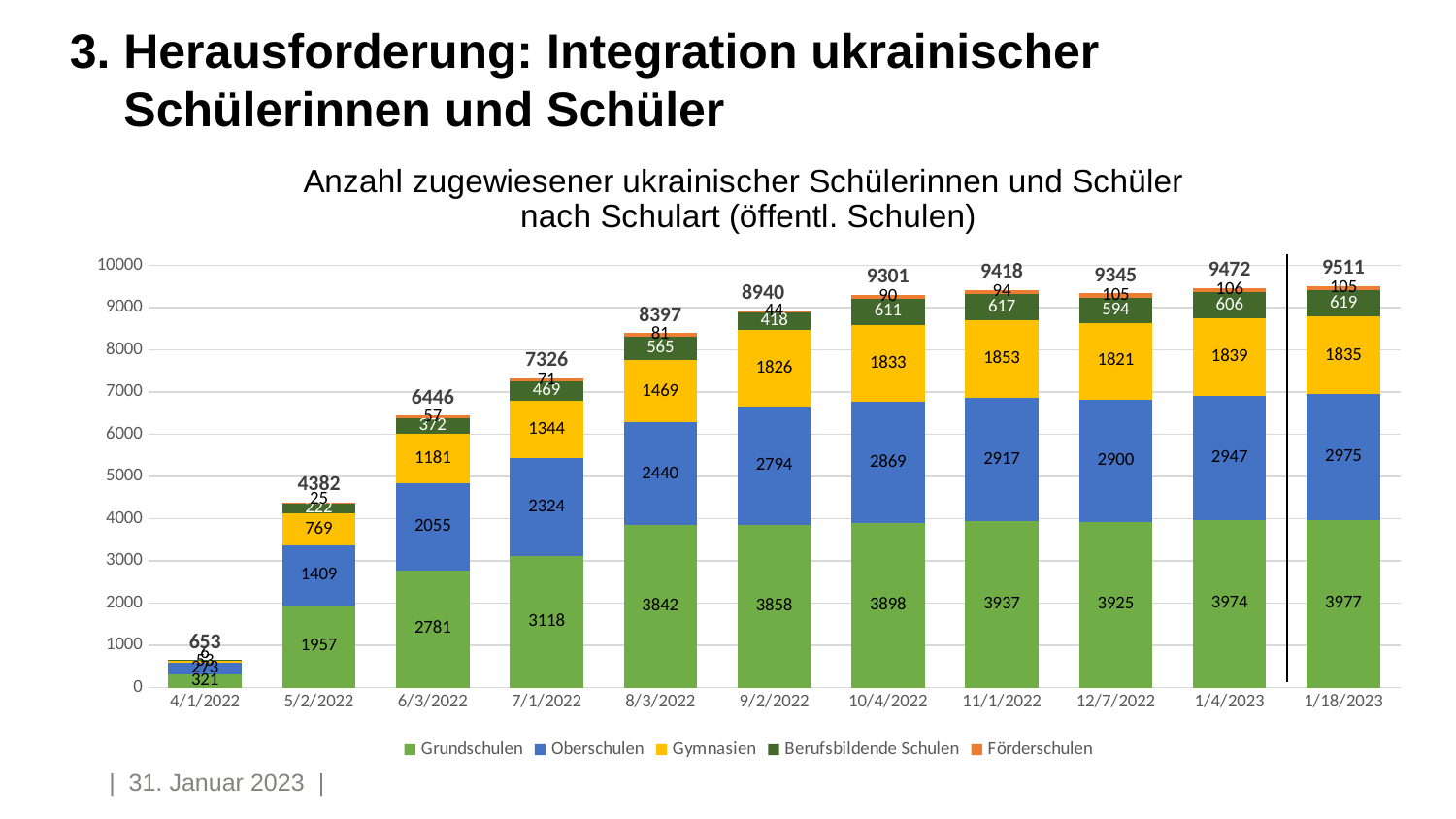
What is the value for Oberschulen on 8/3/2022? 2440 Which date has the lowest total number of students? 4/1/2022 Which date has the highest total number of students? 1/18/2023 How many series does the legend of the chart list? 5 What is the total of the stacked bar for 11/1/2022? 9418 On 7/1/2022, which is larger: the value for Oberschulen or the value for Gymnasien? Oberschulen Do the total values rise or fall from 4/1/2022 to 8/3/2022? Rise What is the value for Grundschulen on 1/18/2023? 3977 How many dates (categories) are shown on the x axis of the chart? 11 What is the difference between the Gymnasien value on 9/2/2022 and on 8/3/2022? 357 What colour represents Gymnasien in the chart legend? Yellow What kind of chart is shown on the slide? Stacked bar chart